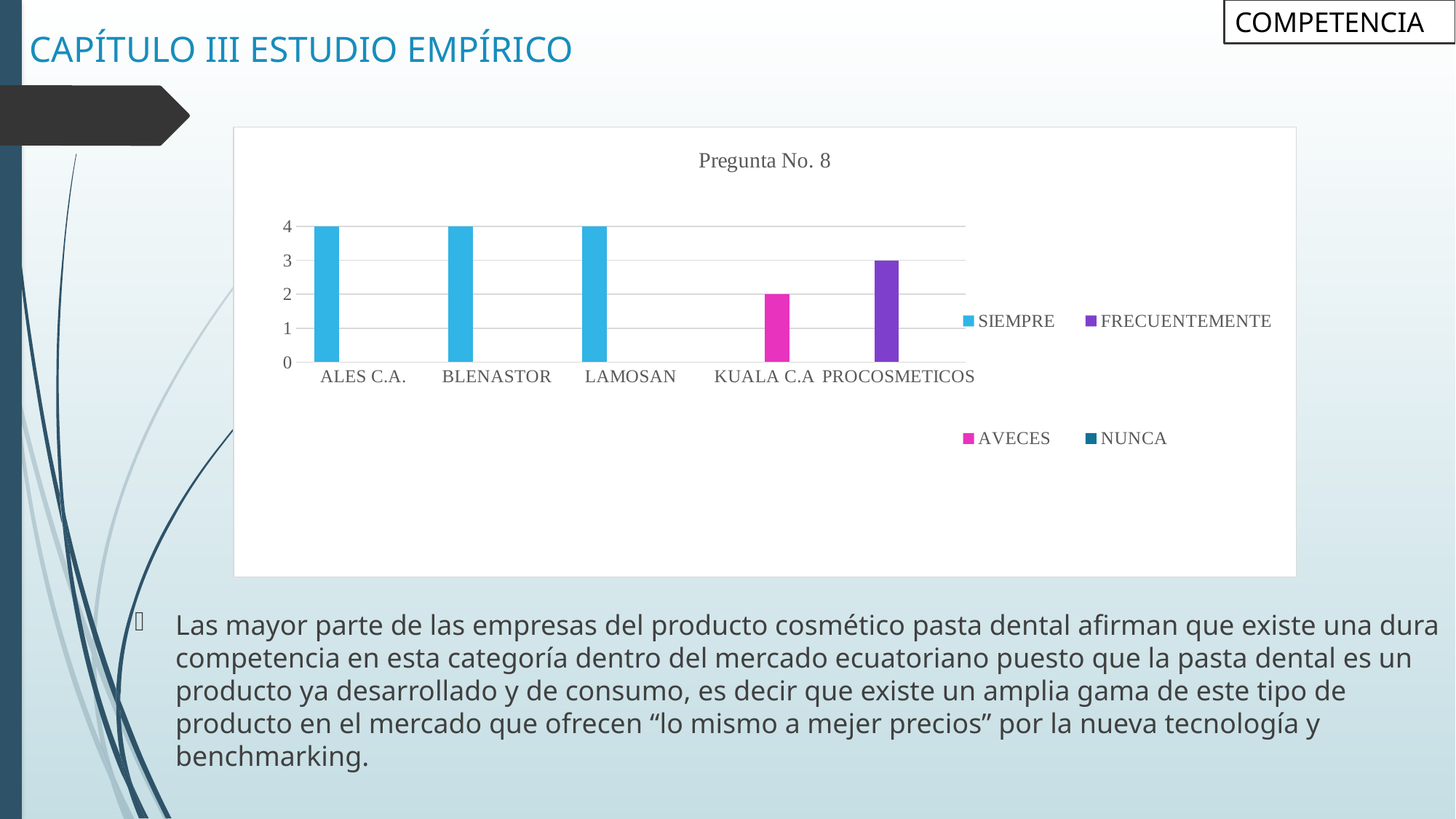
How many series does the legend list? 4 Is the value for BLENASTOR greater or less than 2? greater What is the title of the chart? Pregunta No. 8 What is the value of the SIEMPRE bar for ALES C.A.? 4 What is the value of the FRECUENTEMENTE bar for PROCOSMETICOS? 3 Which company has the lowest bar in the chart? KUALA C.A How many companies are shown on the x axis of the chart? 5 What is the value of the AVECES bar for KUALA C.A? 2 Which is larger, the bar for PROCOSMETICOS or the bar for KUALA C.A? PROCOSMETICOS Which series does the bar for KUALA C.A belong to? AVECES What kind of chart is shown on the slide? bar chart What is the difference between the bar for LAMOSAN and the bar for KUALA C.A? 2